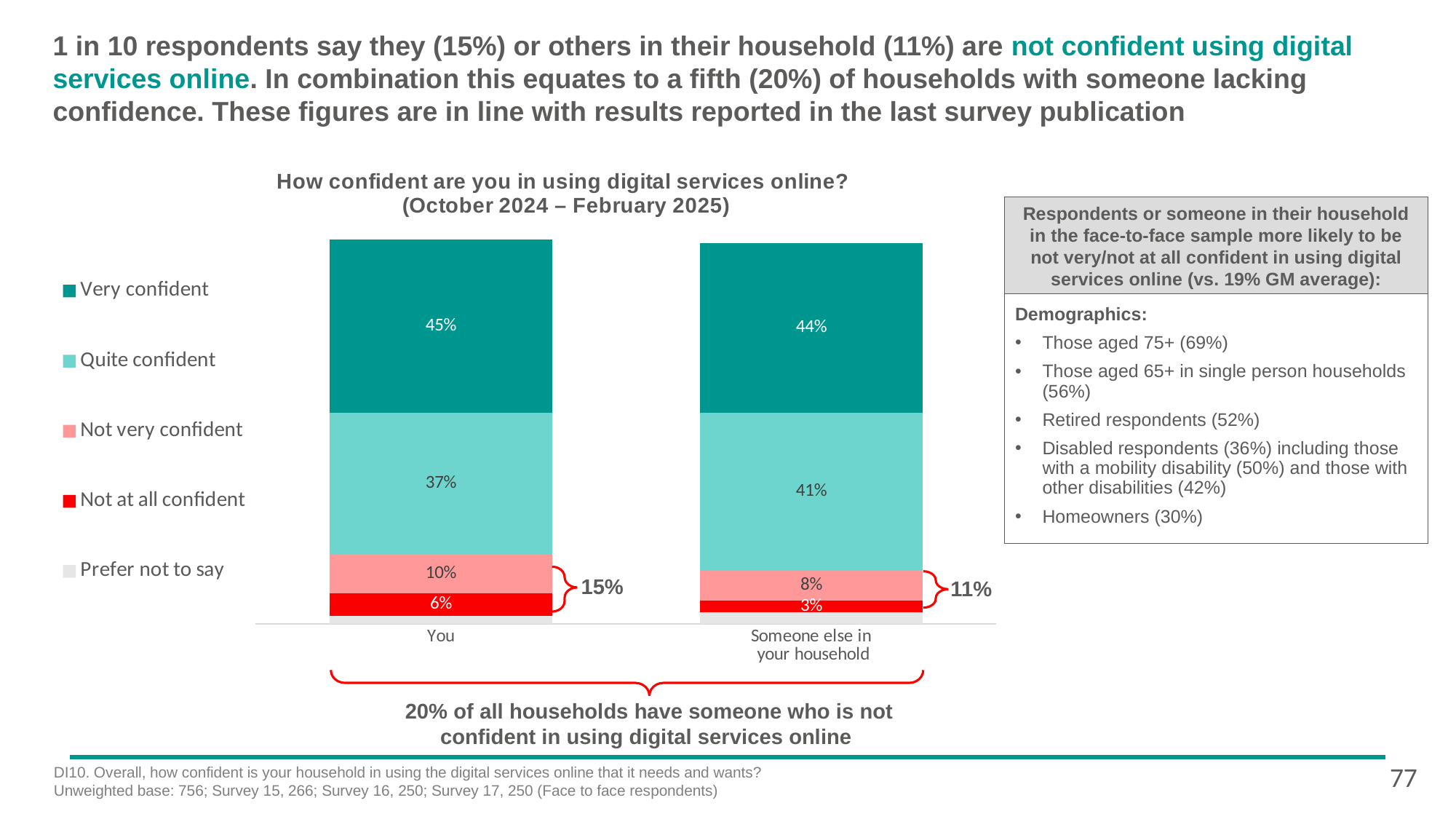
What type of chart is shown on the slide? Stacked bar chart What percentage is shown for 'Quite confident' in the 'Someone else in your household' bar? 41% What combined percentage does the bracket show for 'Not very confident' and 'Not at all confident' in the 'Someone else in your household' bar? 11% Which segment is the largest in the 'You' bar? Very confident What is the title of the chart? How confident are you in using digital services online? (October 2024 – February 2025) What percentage is shown for 'Not very confident' in the 'Someone else in your household' bar? 8% What percentage is shown for 'Not at all confident' in the 'You' bar? 6% Which bar has the higher 'Not at all confident' value, 'You' or 'Someone else in your household'? You How many series does the chart legend list? 5 What is the difference between the 'Quite confident' values for 'You' and 'Someone else in your household'? 4% How many categories (bars) are shown on the x axis of the chart? 2 What percentage of respondents say they are 'Very confident' for the 'You' bar? 45%